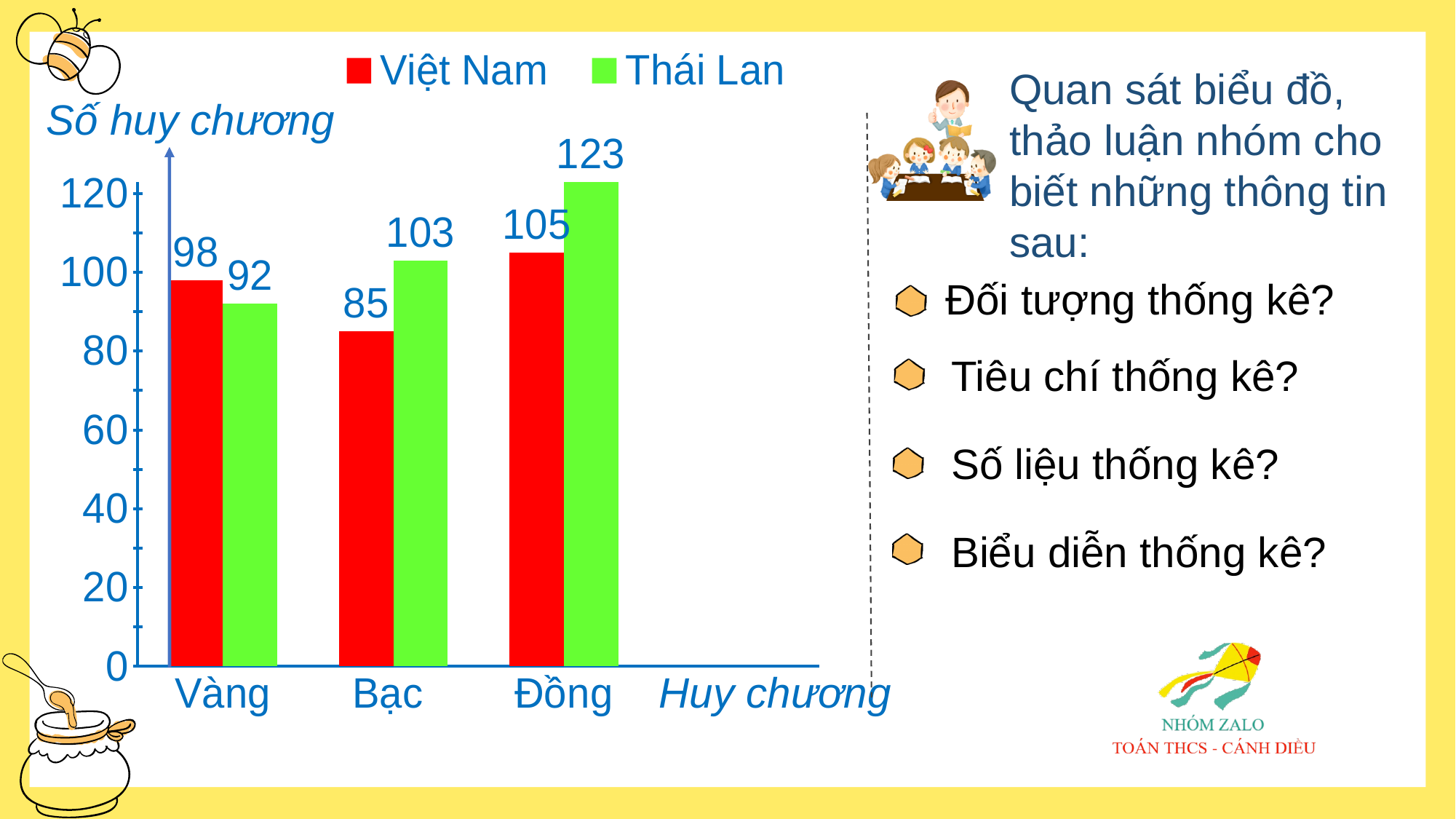
How many medals does Thái Lan have for Đồng? 123 Which is larger for Vàng: Việt Nam or Thái Lan? Việt Nam How many medals does Thái Lan have for Bạc? 103 Which medal category has the lowest value for Việt Nam? Bạc How many medal categories are shown on the x axis? 3 What is the difference between Thái Lan's and Việt Nam's Đồng medals? 18 What kind of chart is shown on the slide? Bar chart What colour represents Thái Lan in the chart? Green How many medals does Việt Nam have for Bạc? 85 Which medal category has the highest value for Thái Lan? Đồng How many series does the legend list? 2 How many medals (Số huy chương) does Việt Nam have for Vàng? 98